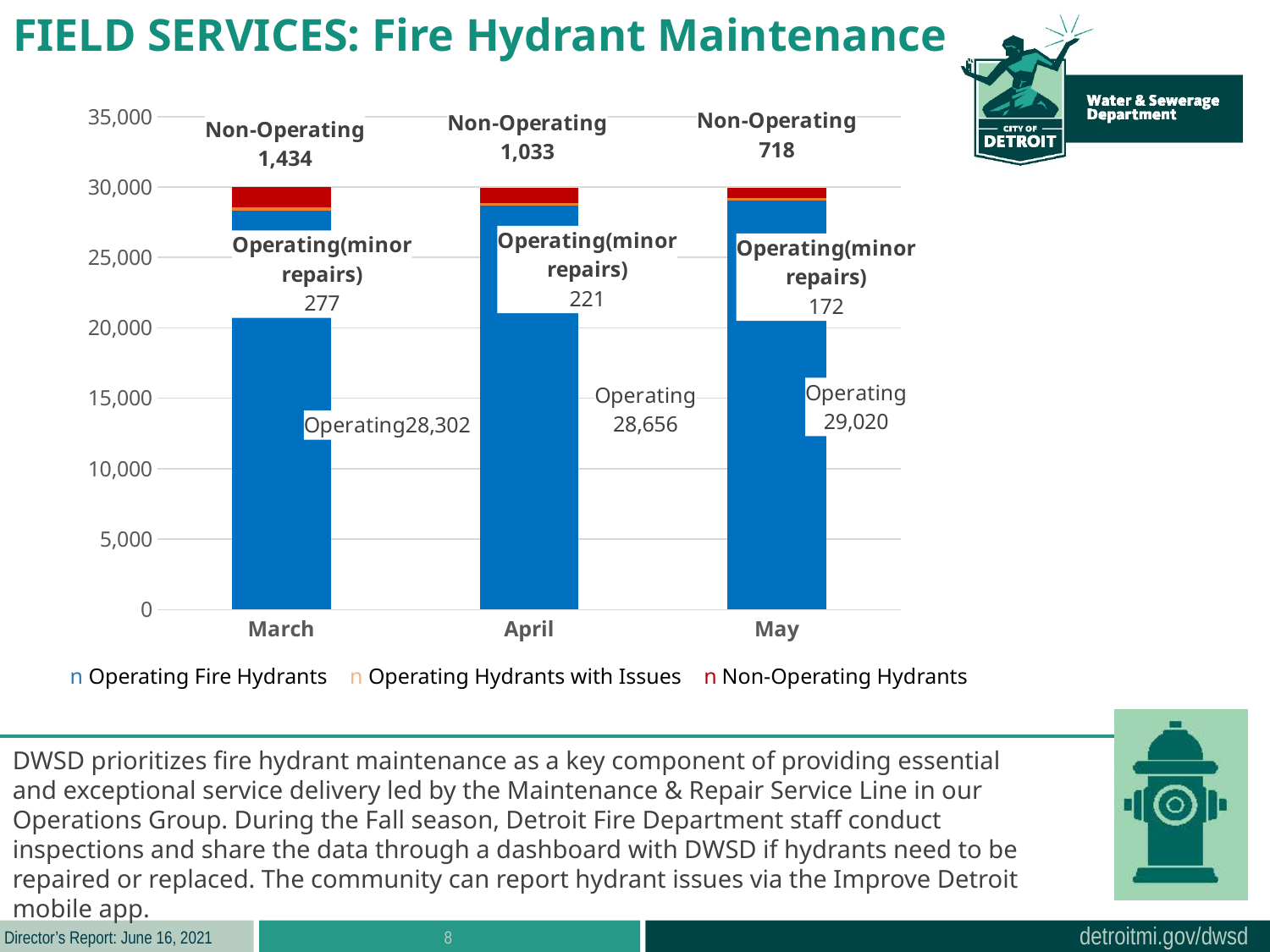
Which month has the highest number of Non-Operating hydrants? March How many series does the legend list? 3 What is the difference between the Non-Operating hydrants in March and in May? 716 Do the Non-Operating hydrant values rise or fall from March to May? Fall How many months are shown on the x axis? 3 What is the total number of hydrants in the March stacked bar? 30,013 Which month has the lowest number of Operating (minor repairs) hydrants? May What is the number of Operating fire hydrants in March? 28,302 What kind of chart is shown on the slide? Stacked bar chart What is the number of Operating (minor repairs) hydrants in April? 221 What is the number of Non-Operating hydrants in May? 718 Which is larger, the number of Operating hydrants in April or in May? May